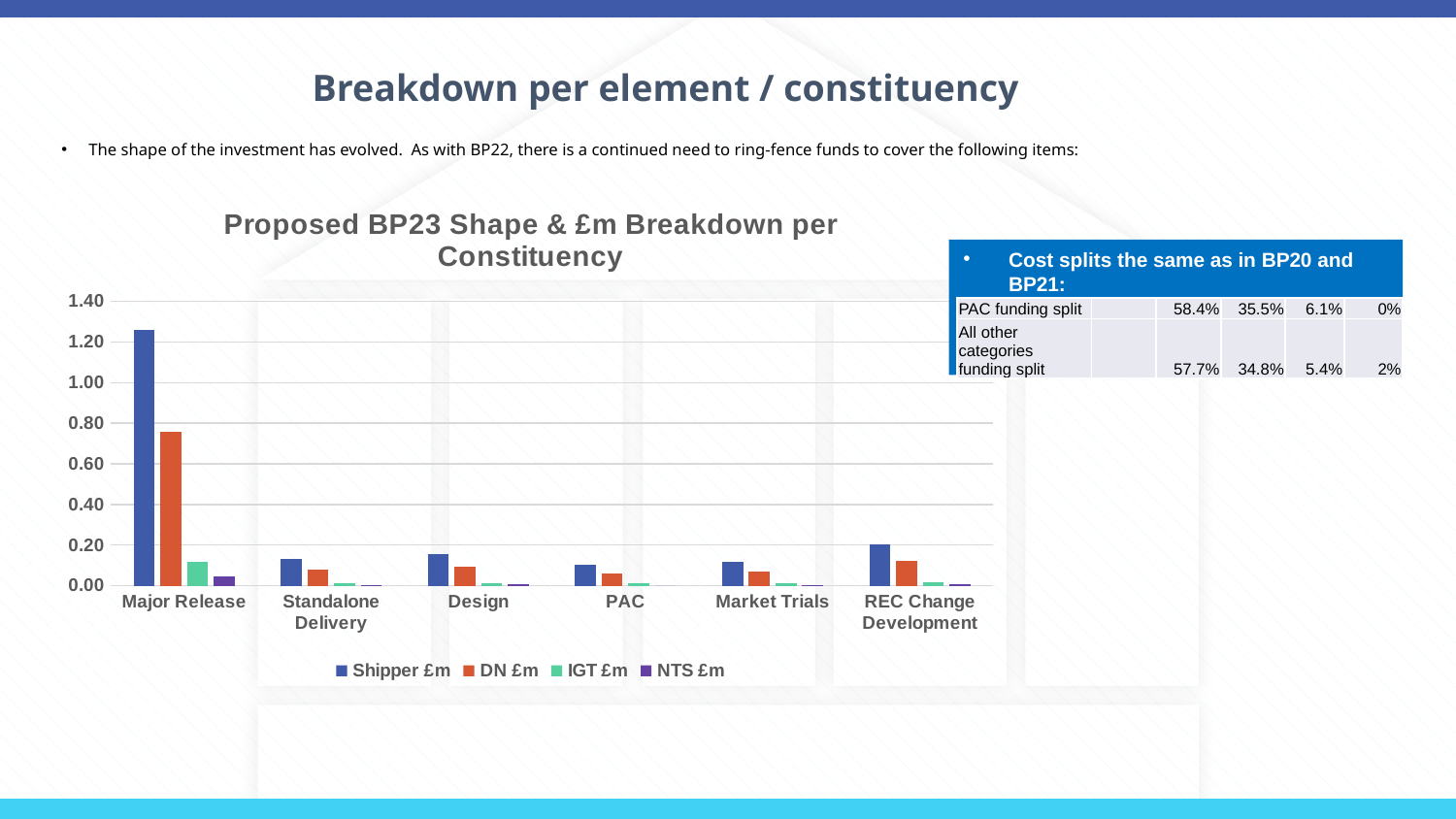
Is the Shipper £m value for REC Change Development greater or less than 0.40? less For Major Release, which is larger: the Shipper £m value or the DN £m value? Shipper £m Which constituency has the highest DN £m value? Major Release Is the Shipper £m value for Major Release greater or less than 1.00? greater Which series is shown in orange in the chart legend? DN £m Which is larger: the Shipper £m value for Major Release or the Shipper £m value for REC Change Development? Major Release How many constituency categories are shown on the x axis of the chart? 6 Which constituency has the highest Shipper £m value? Major Release How many series does the chart legend list? 4 What type of chart is shown on the slide? Bar chart What is the title of the chart? Proposed BP23 Shape & £m Breakdown per Constituency Is the DN £m value for Major Release greater or less than 0.60? greater